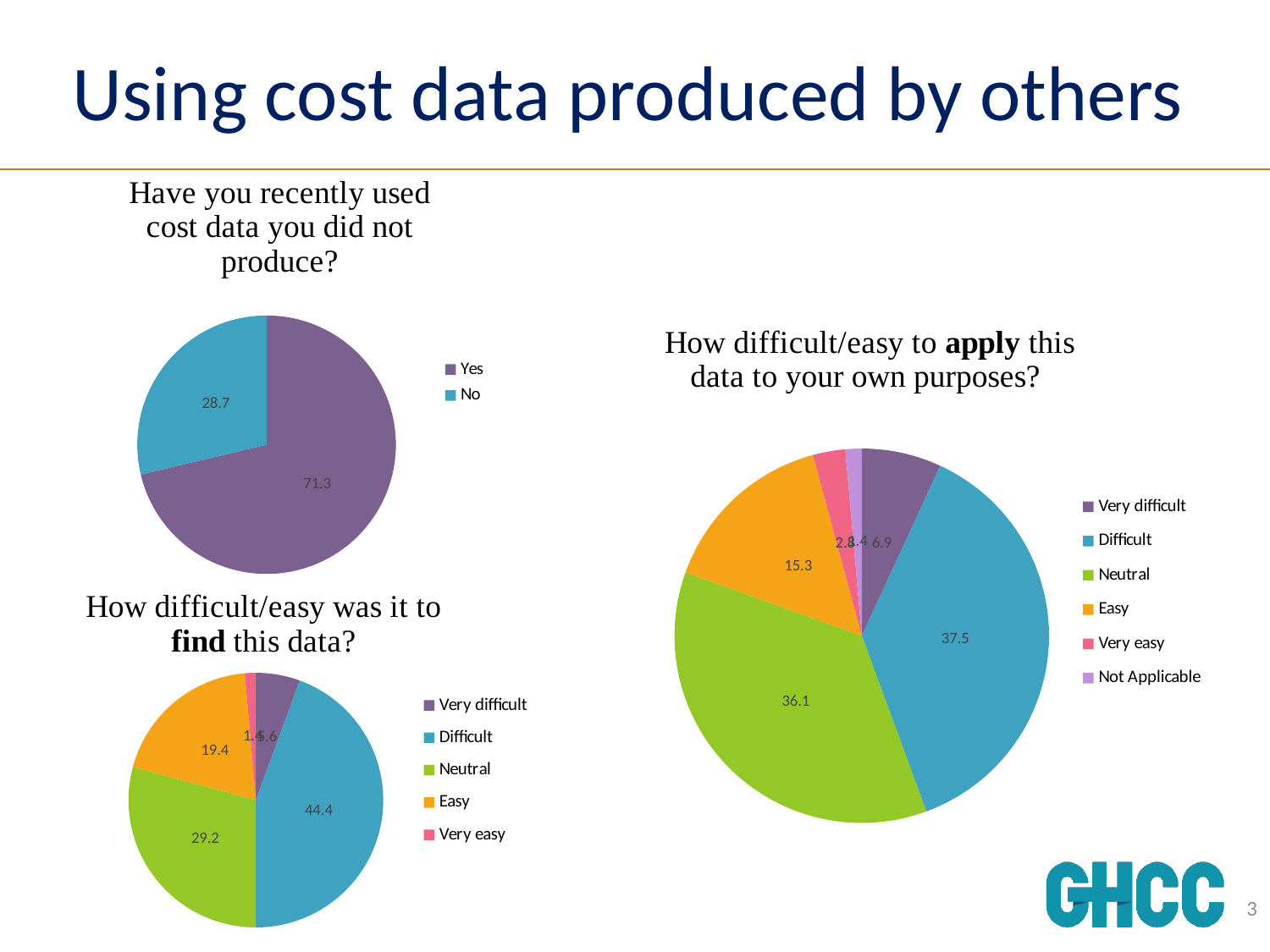
In the pie chart "How difficult/easy was it to find this data?", which category has the largest slice? Difficult What kind of chart is used for "Have you recently used cost data you did not produce?"? pie chart In the pie chart "How difficult/easy to apply this data to your own purposes?", what value is shown for Easy? 15.3 In the pie chart "How difficult/easy was it to find this data?", which category has the smallest slice? Very easy In the pie chart "How difficult/easy to apply this data to your own purposes?", what value is shown for Difficult? 37.5 How many categories does the legend list for the chart "How difficult/easy to apply this data to your own purposes?"? 6 In the pie chart "How difficult/easy was it to find this data?", what is the difference between the Difficult and Neutral values? 15.2 In the pie chart titled "Have you recently used cost data you did not produce?", what value is shown for No? 28.7 How many categories does the legend list for the chart "Have you recently used cost data you did not produce?"? 2 In the pie chart titled "Have you recently used cost data you did not produce?", what value is shown for Yes? 71.3 In the pie chart "How difficult/easy was it to find this data?", what value is shown for Neutral? 29.2 In the pie chart "How difficult/easy was it to find this data?", what value is shown for Difficult? 44.4